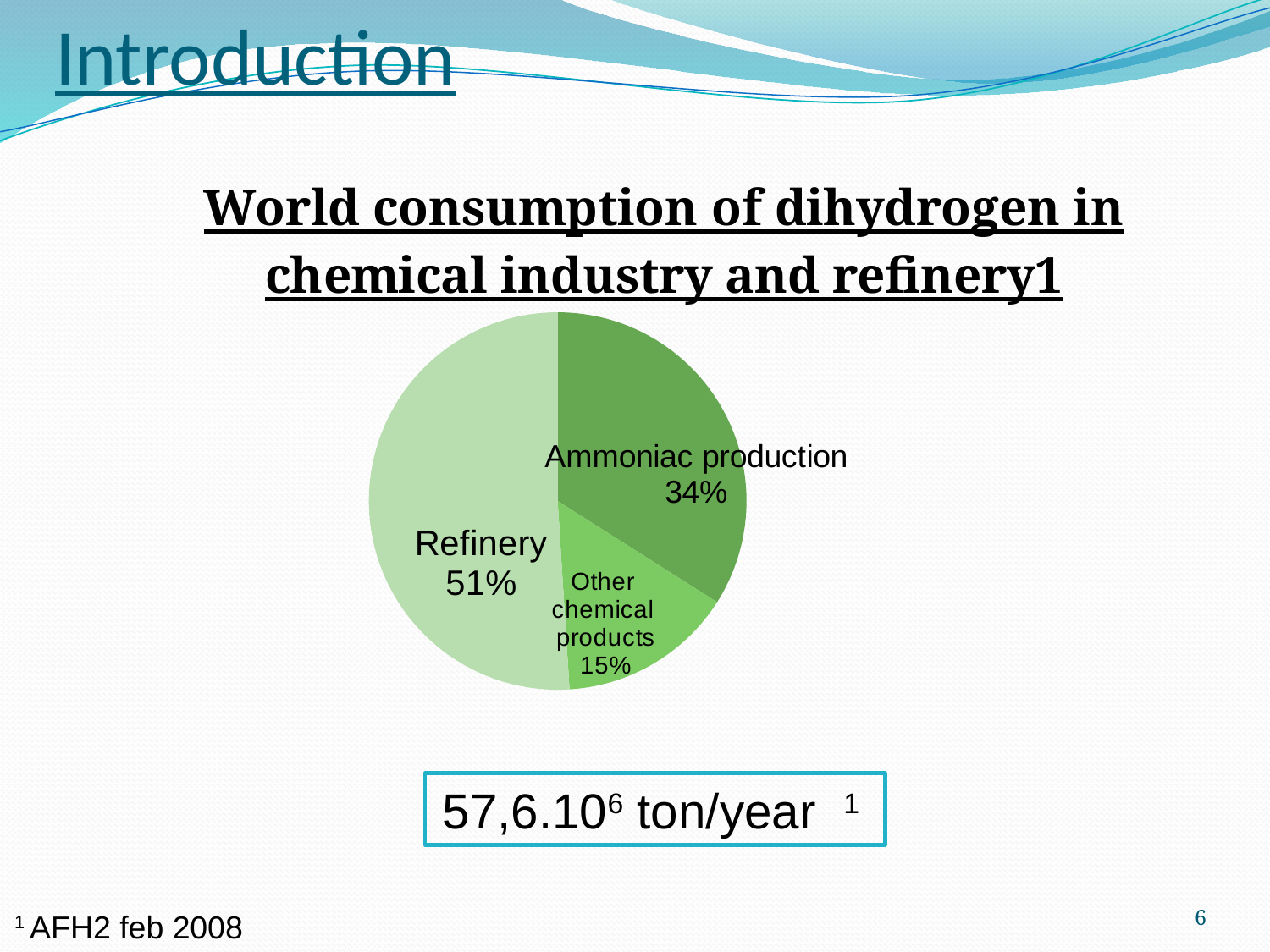
What type of chart is shown on the slide? pie chart What share of world dihydrogen consumption goes to Ammoniac production? 34% What is the difference in percentage points between the Ammoniac production share and the Other chemical products share? 19 Which category has the smallest share of the pie? Other chemical products What share of world dihydrogen consumption goes to Refinery? 51% What is the difference in percentage points between the Refinery share and the Ammoniac production share? 17 Is the Refinery share greater or less than 50%? greater Which is larger, the share for Ammoniac production or the share for Other chemical products? Ammoniac production Which category has the largest share of the pie? Refinery How many slices does the pie chart have? 3 What share of world dihydrogen consumption goes to Other chemical products? 15% What is the title of the pie chart? World consumption of dihydrogen in chemical industry and refinery1